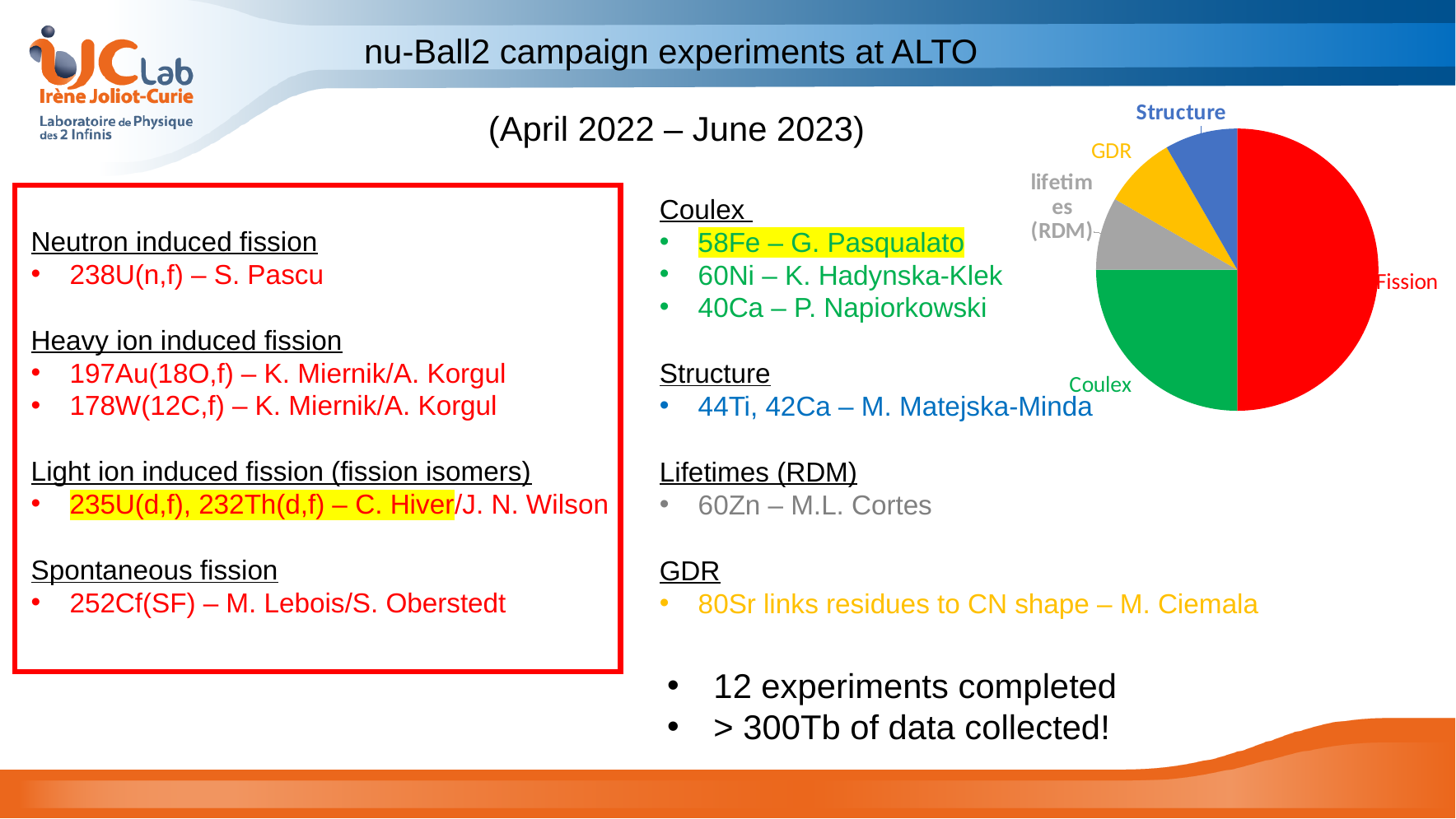
How many slices does the pie chart have? 5 Which is larger in the pie chart, Fission or Coulex? Fission Which is larger in the pie chart, Coulex or lifetimes (RDM)? Coulex What kind of chart is shown on the slide? pie chart Which category has the largest slice in the pie chart? Fission What colour is the Coulex slice in the pie chart? green Which is larger in the pie chart, Fission or Structure? Fission What colour is the Fission slice in the pie chart? red Which category has the second-largest slice in the pie chart? Coulex